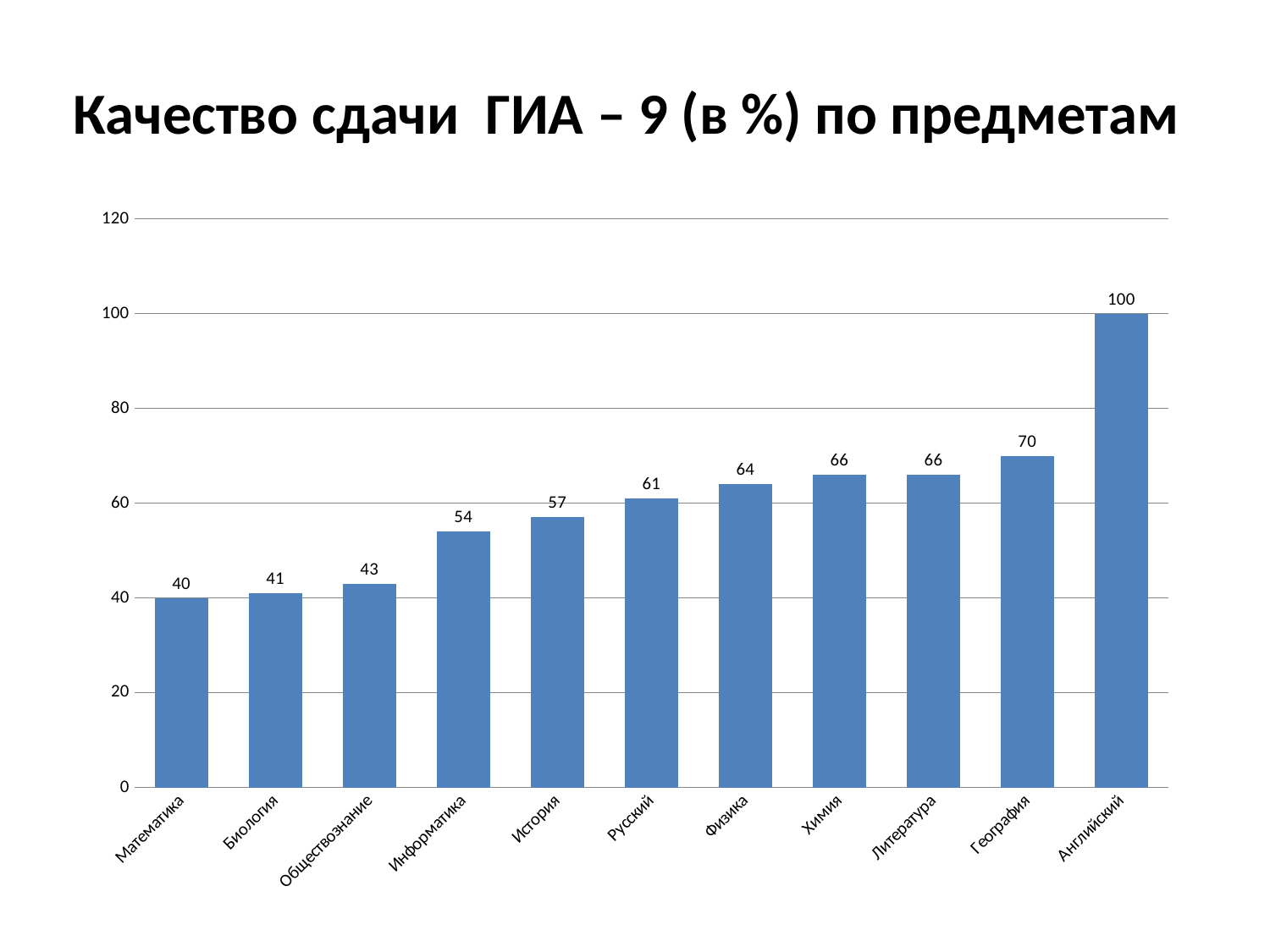
Which subject has the lowest value? Математика What is the title of the slide? Качество сдачи ГИА – 9 (в %) по предметам Is the value for Химия greater or less than 60? greater Which is larger, the value for Физика or the value for История? Физика How many subjects are shown on the chart? 11 Which subject has the highest value? Английский What is the value for Математика? 40 What is the difference between the values for Английский and География? 30 What kind of chart is shown on the slide? bar chart What is the value for География? 70 What is the value for Информатика? 54 What is the difference between the values for Русский and Биология? 20